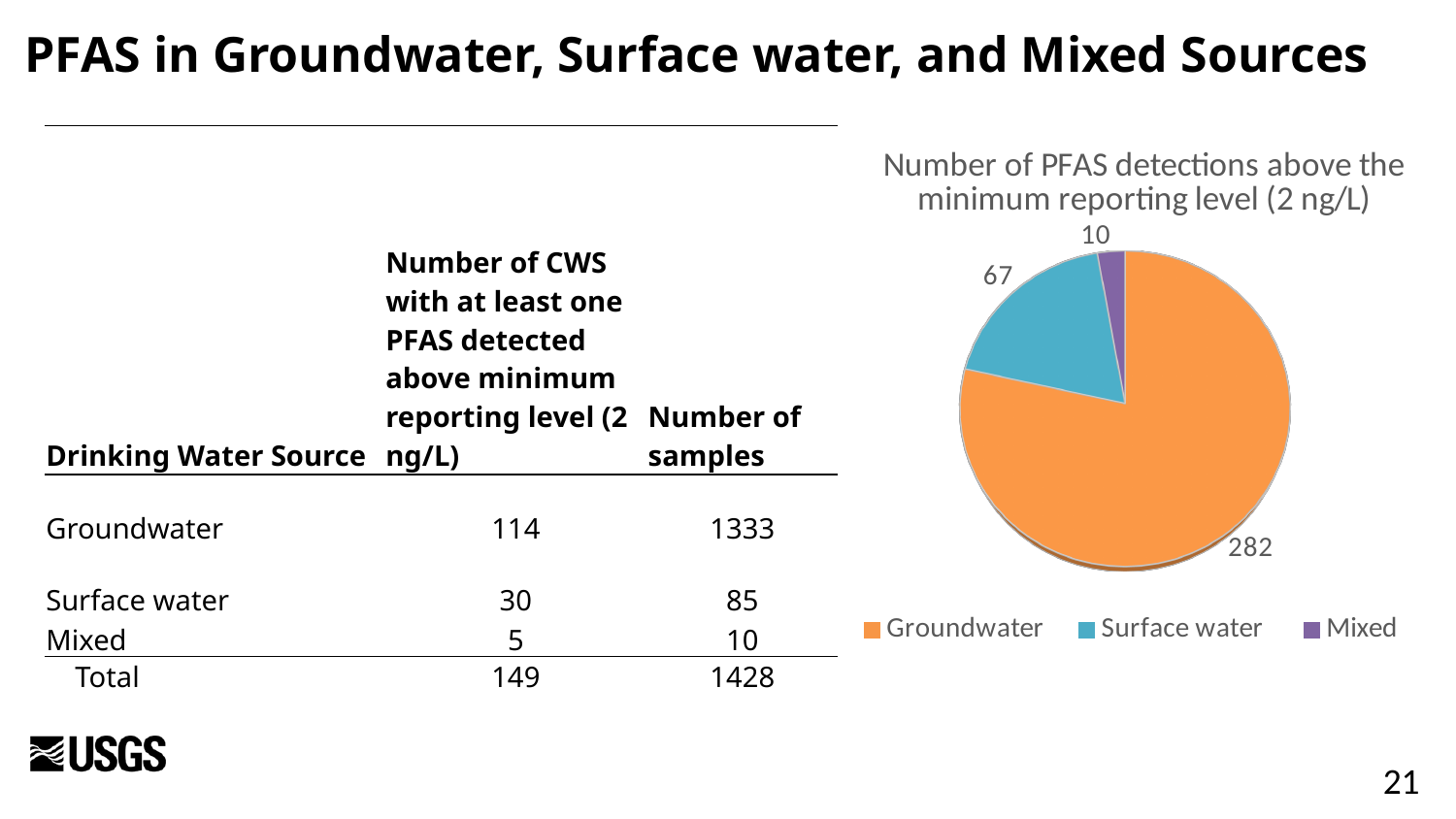
What is the total of all three slices in the pie chart? 359 What is the difference between the Groundwater and Surface water values in the pie chart? 215 Which source has the largest slice in the pie chart? Groundwater What kind of chart is shown on the slide? Pie chart What is the number of PFAS detections for Mixed in the pie chart? 10 Which is larger in the pie chart, the Surface water value or the Mixed value? Surface water What is the number of PFAS detections for Surface water in the pie chart? 67 How many slices does the pie chart have? 3 How many entries does the pie chart's legend list? 3 What is the number of PFAS detections for Groundwater in the pie chart? 282 What is the title of the pie chart? Number of PFAS detections above the minimum reporting level (2 ng/L) Which source has the smallest slice in the pie chart? Mixed